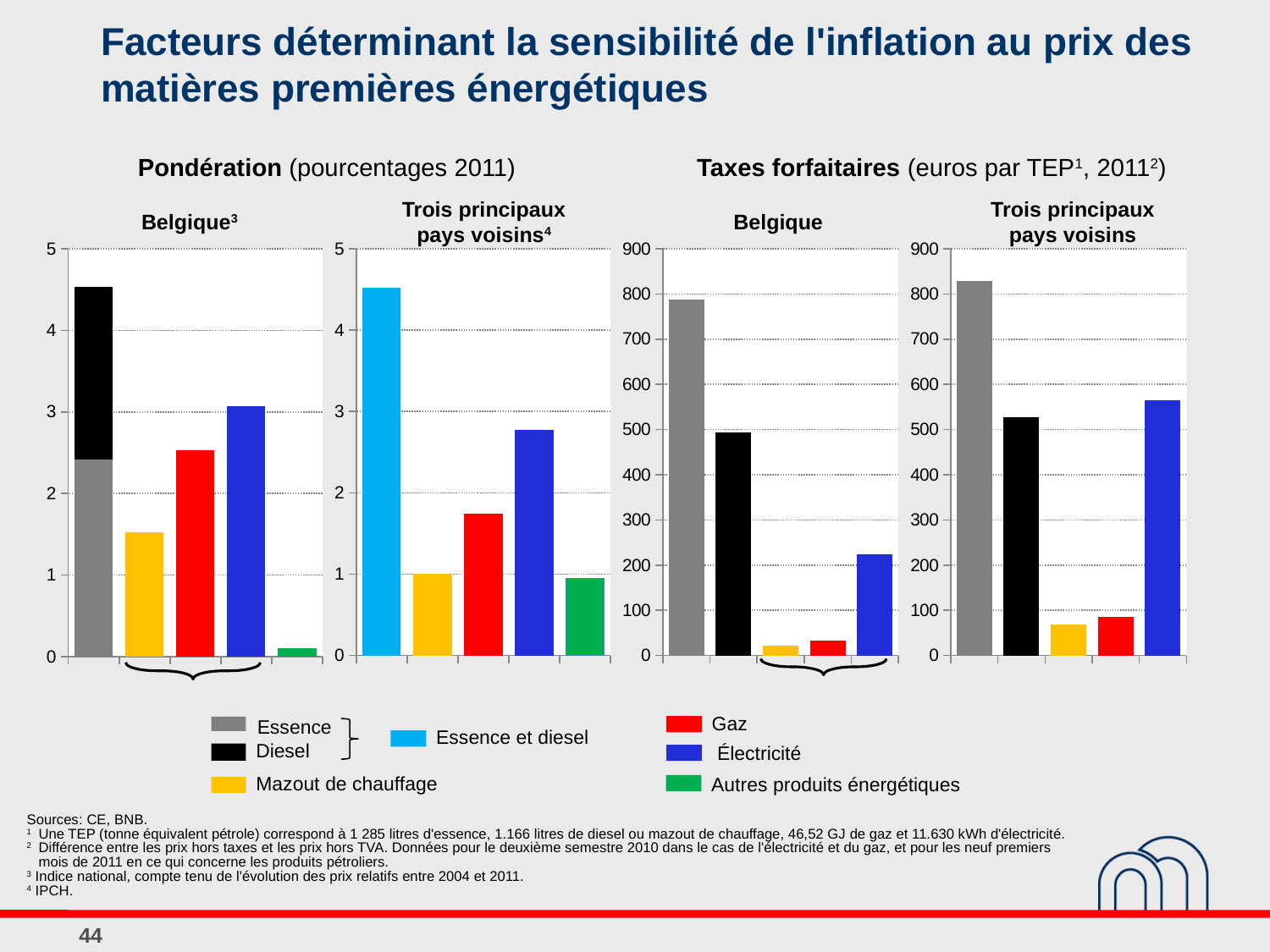
In the Pondération Trois principaux pays voisins chart, is the value for Essence et diesel greater or less than 4? greater In the Taxes forfaitaires Trois principaux pays voisins chart, is the value for Électricité greater or less than 500? greater In the Pondération Trois principaux pays voisins chart, which category has the highest weight? Essence et diesel Is the tax on Électricité higher in the Taxes forfaitaires Belgique chart or in the Taxes forfaitaires Trois principaux pays voisins chart? Trois principaux pays voisins How many bars are shown in the Taxes forfaitaires Belgique chart? 5 In the Taxes forfaitaires Belgique chart, which energy product has the highest tax? Essence In the Pondération Belgique chart, is the value for Gaz greater or less than 2? greater What kind of chart is used for the Taxes forfaitaires Belgique panel? bar chart In the Taxes forfaitaires Trois principaux pays voisins chart, which is larger, the tax on Électricité or the tax on Diesel? Électricité In the Pondération Belgique chart, which energy product has the lowest weight? Autres produits énergétiques